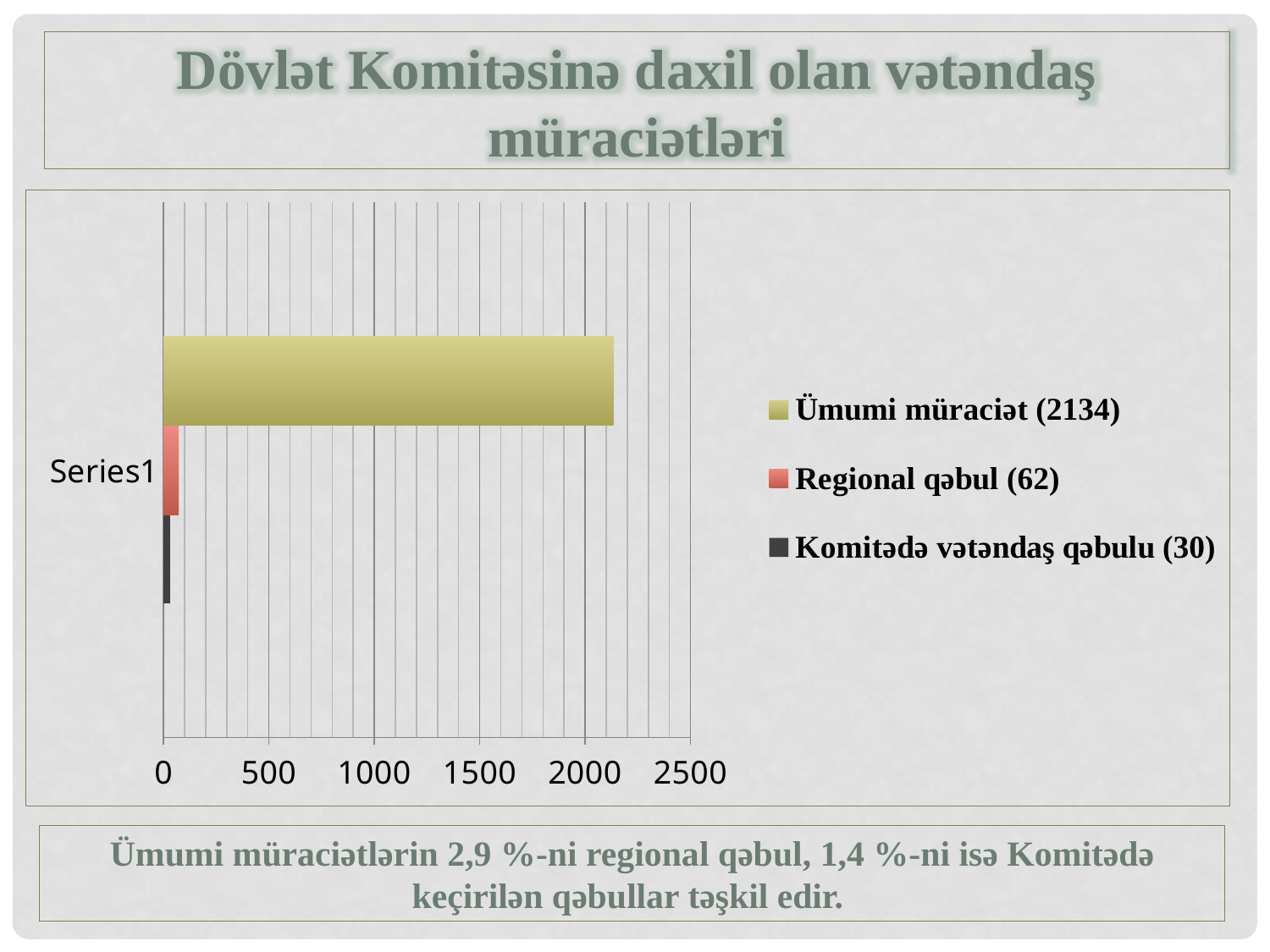
Which is larger, the value for Regional qəbul or the value for Komitədə vətəndaş qəbulu? Regional qəbul What is the difference between the values for Ümumi müraciət and Regional qəbul? 2072 What is the difference between the values for Regional qəbul and Komitədə vətəndaş qəbulu? 32 Which series has the highest value? Ümumi müraciət What is the value for Komitədə vətəndaş qəbulu? 30 What is the value for Regional qəbul? 62 Which series has the lowest value? Komitədə vətəndaş qəbulu What type of chart is shown on the slide? bar chart How many series does the legend list? 3 What is the value for Ümumi müraciət? 2134 Is the value for Ümumi müraciət greater or less than 2000? greater What is the title of the chart on the slide? Dövlət Komitəsinə daxil olan vətəndaş müraciətləri